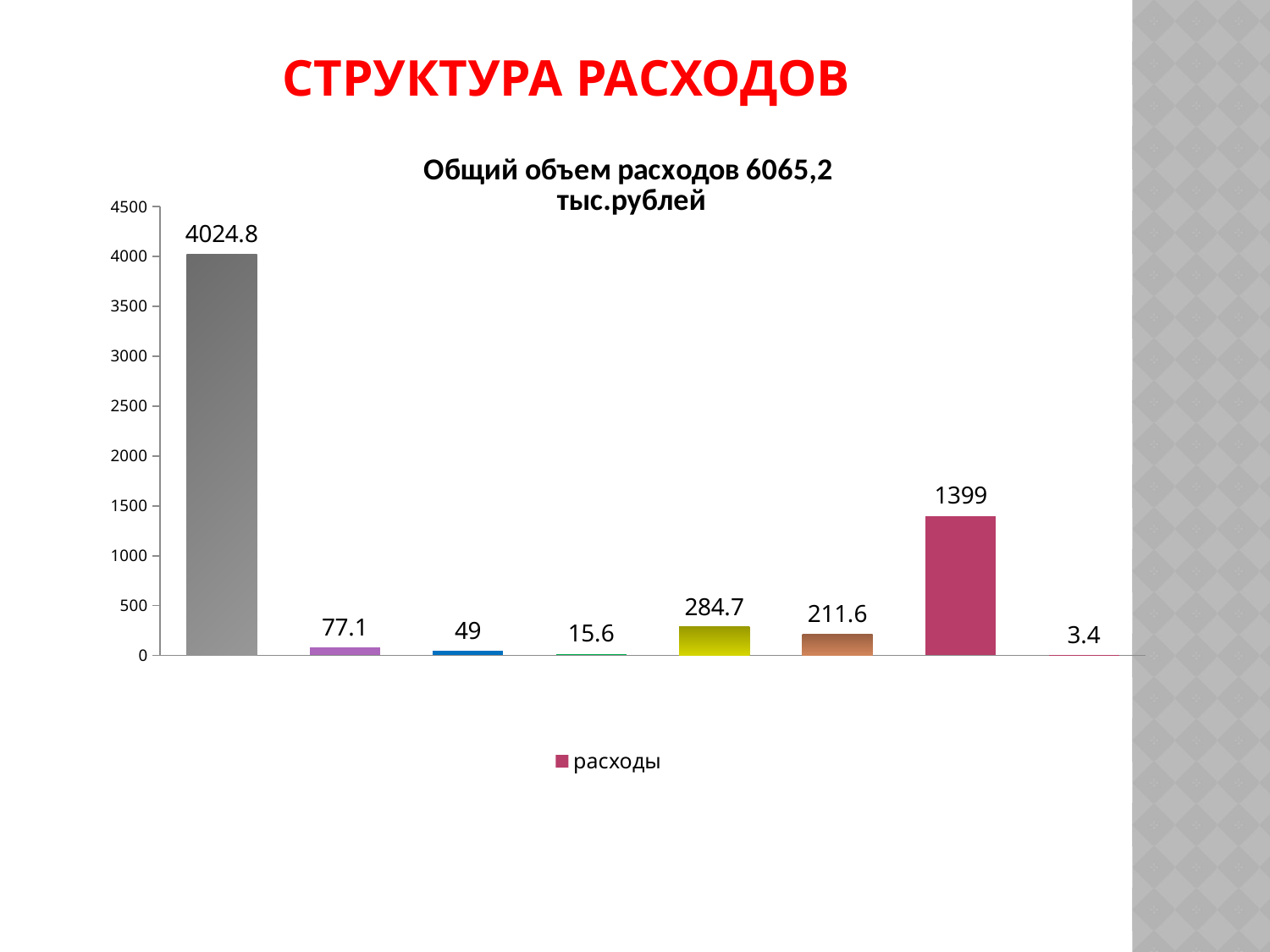
What is the value of the seventh bar (the dark pink one)? 1399 What is the value of the fifth bar (the yellow-green one)? 284.7 Which bar has the lowest value? the last (rightmost) bar, 3.4 What is the value of the first (leftmost, grey) bar? 4024.8 How many series does the legend list? 1 What is the difference between the first bar (4024.8) and the seventh bar (1399)? 2625.8 What is the value of the last (rightmost) bar? 3.4 What type of chart is shown on the slide? bar chart What is the title of the chart? Общий объем расходов 6065,2 тыс.рублей How many bars are plotted in the chart? 8 Which bar has the highest value? the first (leftmost, grey) bar, 4024.8 What is the name of the series shown in the legend? расходы